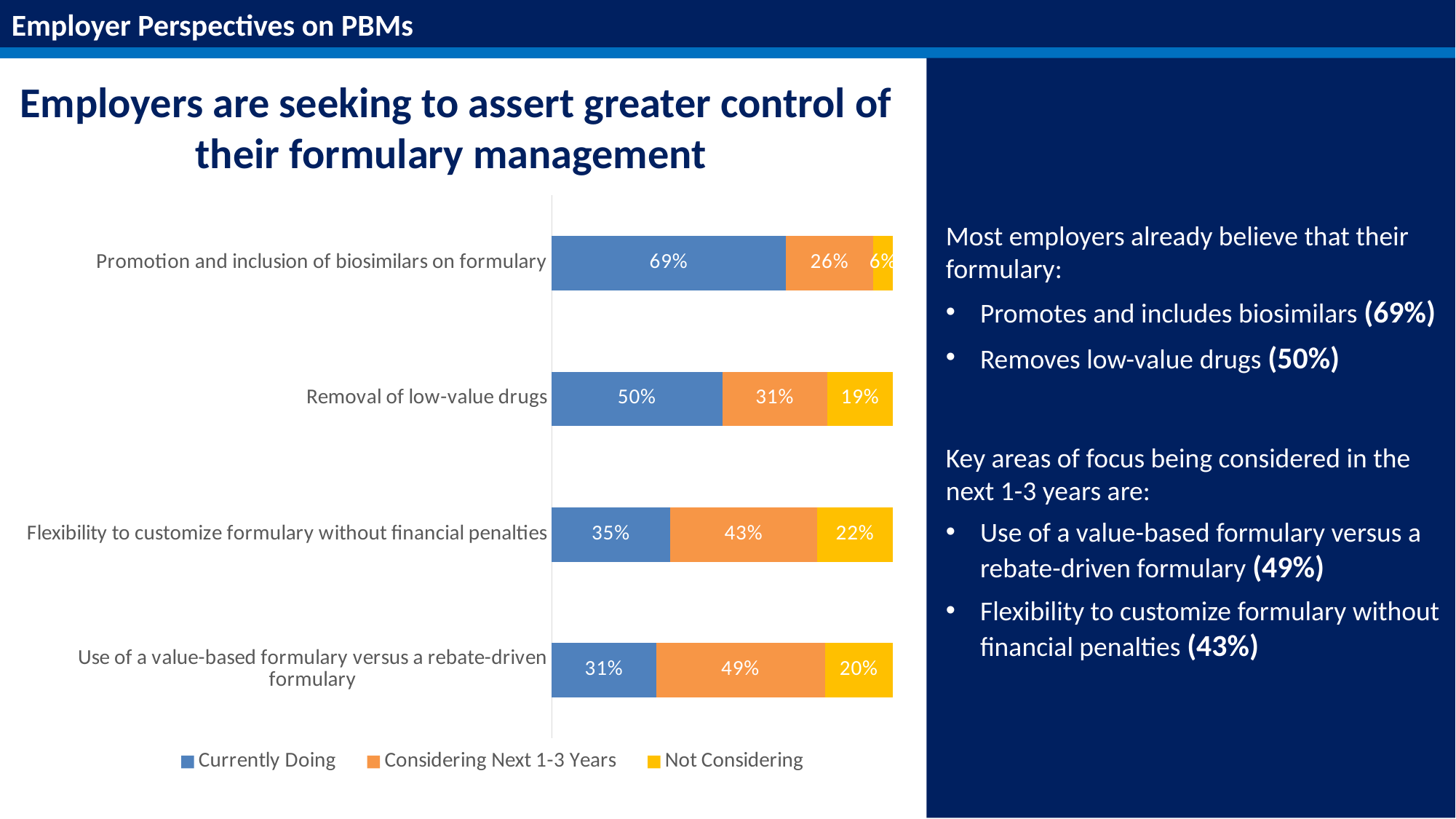
Which category has the highest 'Currently Doing' value? Promotion and inclusion of biosimilars on formulary What percentage of employers are currently doing flexibility to customize formulary without financial penalties? 35% Which category has the lowest 'Not Considering' value? Promotion and inclusion of biosimilars on formulary Which is larger: the 'Considering Next 1-3 Years' value for flexibility to customize formulary without financial penalties or for removal of low-value drugs? Flexibility to customize formulary without financial penalties How many series does the legend list? 3 What percentage of employers are not considering removal of low-value drugs? 19% What is the difference between the 'Currently Doing' values for removal of low-value drugs and use of a value-based formulary versus a rebate-driven formulary? 19% Which series is shown in yellow in the chart? Not Considering What percentage of employers are considering use of a value-based formulary versus a rebate-driven formulary in the next 1-3 years? 49% What percentage of employers are currently doing promotion and inclusion of biosimilars on formulary? 69% How many categories are shown in the chart? 4 What kind of chart is shown on the slide? Stacked bar chart